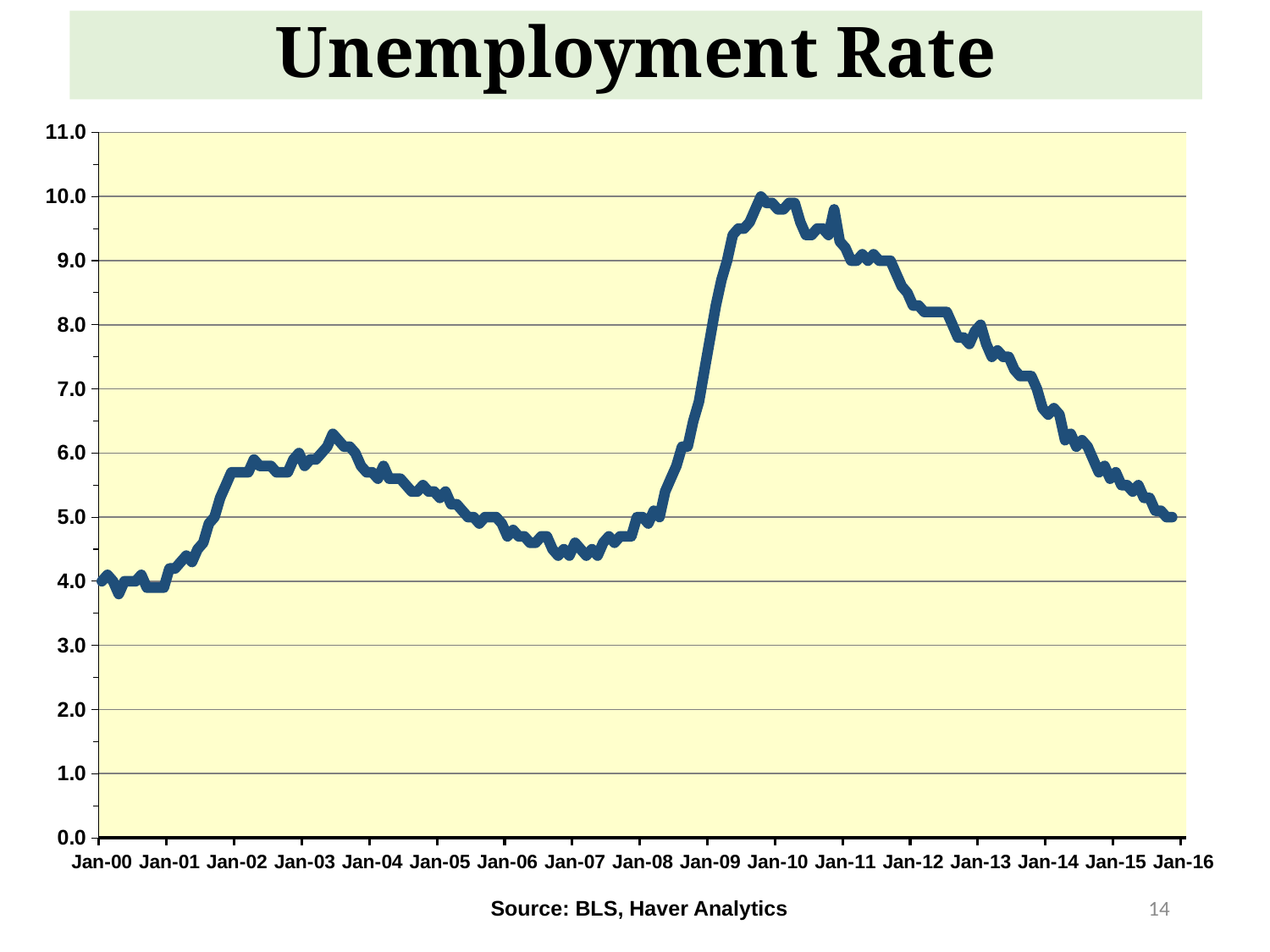
Is the value at Jan-14 greater or less than 6.0? greater What is the title of the chart? Unemployment Rate Is the value at Jan-10 greater or less than 9.0? greater Is the value at Jan-07 greater or less than 5.0? less What kind of chart is shown on the slide? line chart What source is cited below the chart? BLS, Haver Analytics Which is larger, the value at Jan-10 or the value at Jan-03? Jan-10 Between which two x-axis labels does the line reach its highest point? Jan-09 and Jan-10 Does the line rise or fall between Jan-10 and Jan-16? fall How many date labels are shown on the x axis? 17